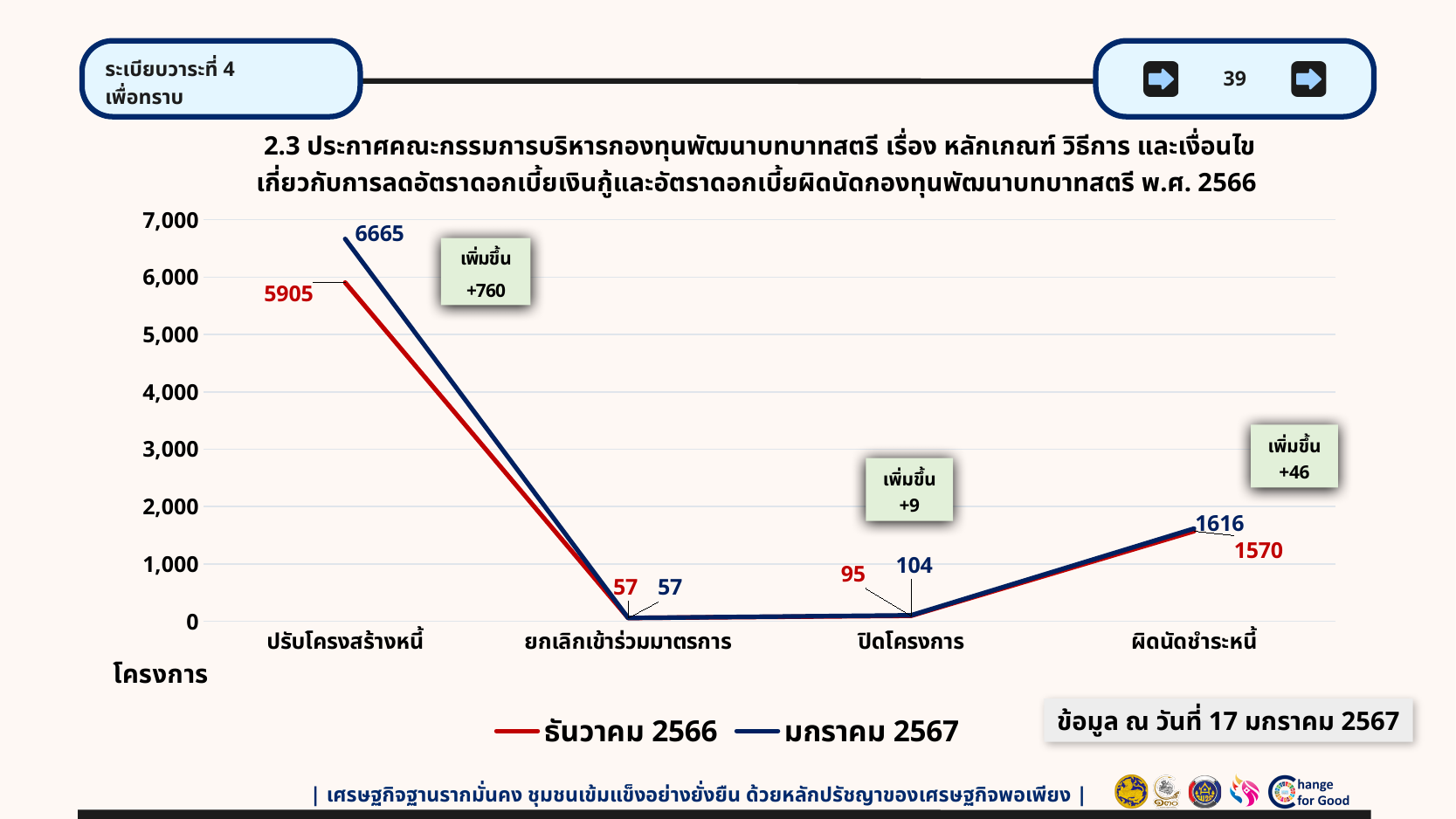
Which series has the larger value for ผิดนัดชำระหนี้, ธันวาคม 2566 or มกราคม 2567? มกราคม 2567 What is the value for ผิดนัดชำระหนี้ in the ธันวาคม 2566 series? 1570 What is the value for ปิดโครงการ in the มกราคม 2567 series? 104 What kind of chart is shown on the slide? line chart What is the difference between the มกราคม 2567 and ธันวาคม 2566 values for ปรับโครงสร้างหนี้? 760 How many categories are shown on the x axis? 4 Which colour is used for the ธันวาคม 2566 series? red What is the value for ปรับโครงสร้างหนี้ in the มกราคม 2567 series? 6665 How many series does the legend list? 2 Which category has the highest value in the มกราคม 2567 series? ปรับโครงสร้างหนี้ Which category has the lowest value in the ธันวาคม 2566 series? ยกเลิกเข้าร่วมมาตรการ What is the value for ปรับโครงสร้างหนี้ in the ธันวาคม 2566 series? 5905